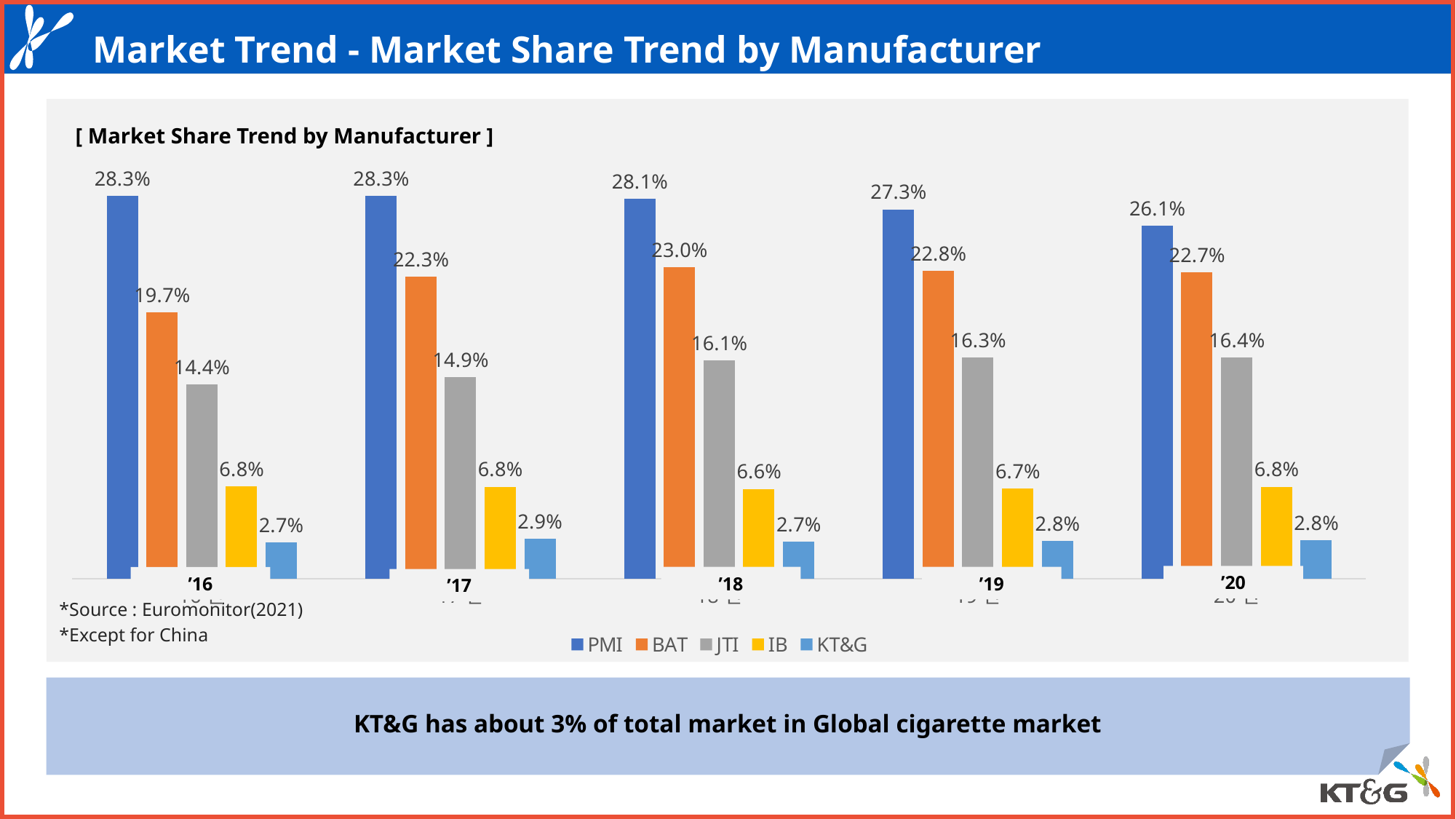
How many years are shown on the x axis? 5 How many series does the legend list? 5 Which manufacturer had the lowest market share in '20? KT&G What was KT&G's market share in '17? 2.9% Does PMI's market share rise or fall from '16 to '20? Fall What was PMI's market share in '16? 28.3% What kind of chart is shown on the slide? Bar chart What was BAT's market share in '18? 23.0% What is the difference between PMI's and BAT's market share in '20? 3.4% What was JTI's market share in '20? 16.4% Which was larger in '18, JTI's market share or IB's market share? JTI Which manufacturer had the highest market share in '19? PMI